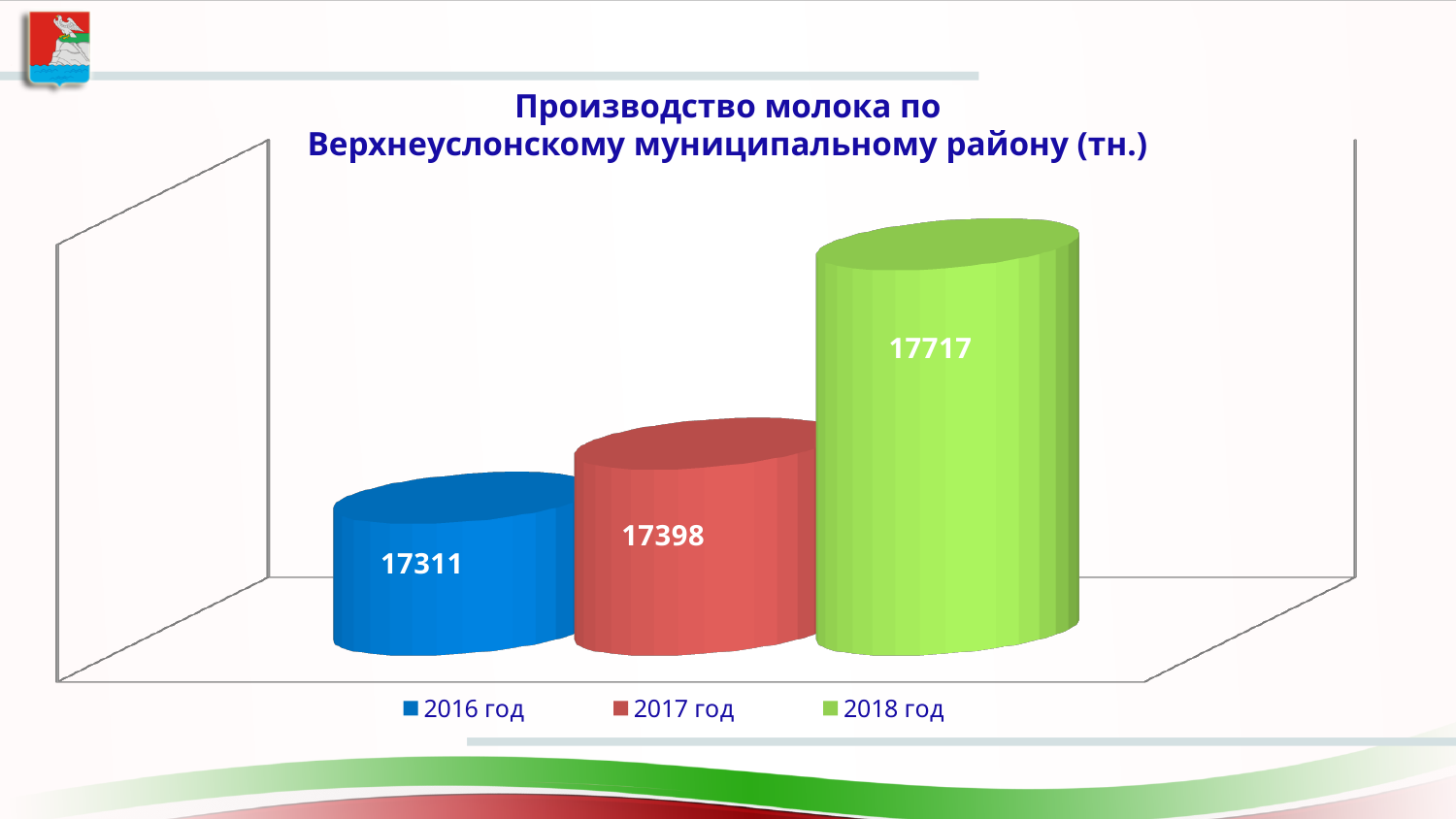
Which year has the highest milk production? 2018 год What is the milk production value for 2018 год? 17717 Which is larger, the value for 2017 год or the value for 2018 год? 2018 год What colour is the bar for 2018 год? green What is the difference in milk production between 2017 год and 2016 год? 87 What is the difference in milk production between 2018 год and 2016 год? 406 How many series does the legend list? 3 What is the milk production value for 2016 год? 17311 Do the values rise or fall from 2016 год to 2018 год? rise Which year has the lowest milk production? 2016 год What is the milk production value for 2017 год? 17398 What kind of chart is shown on the slide? bar chart